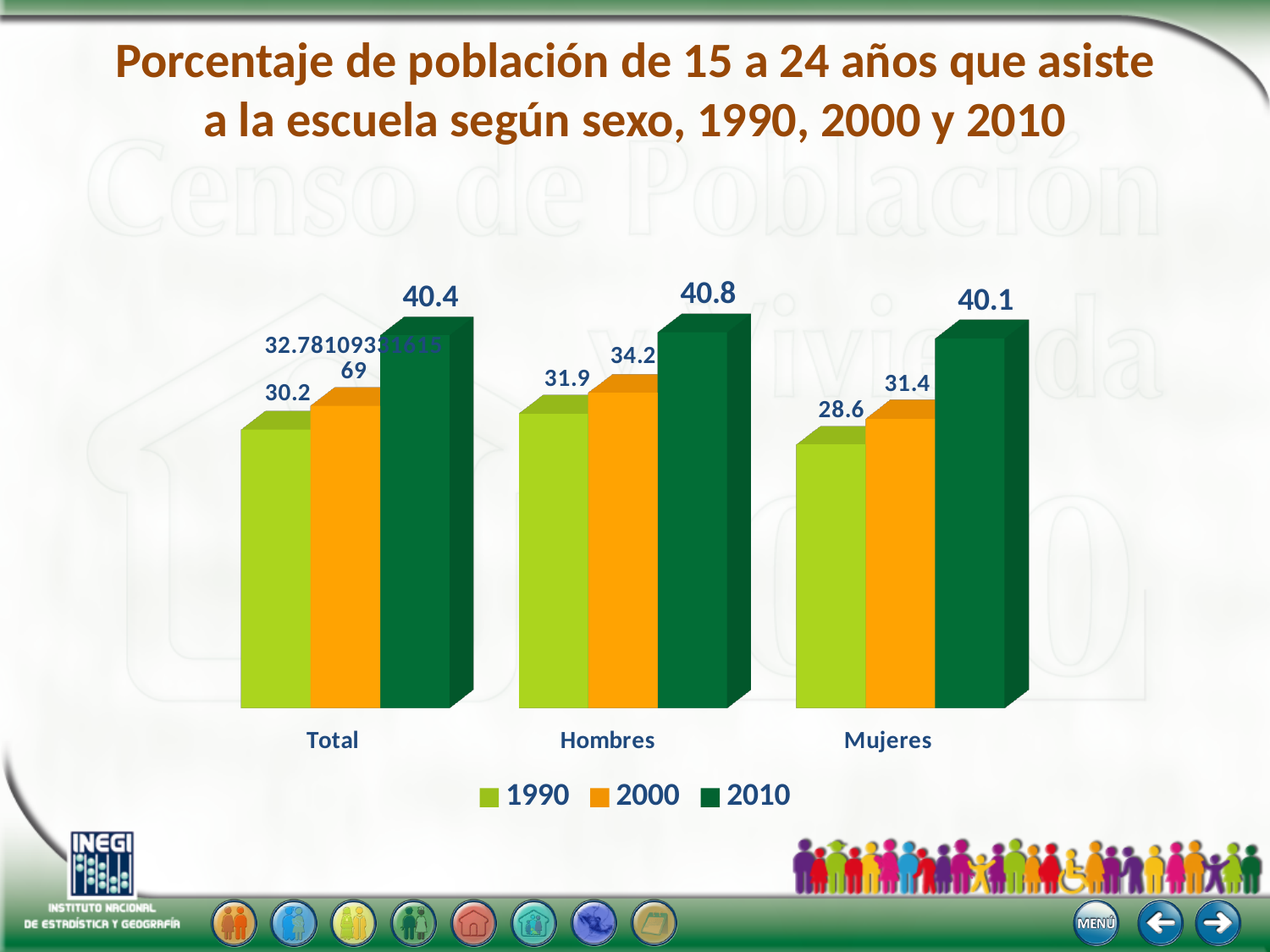
What is the difference between the 2010 and 1990 values for Mujeres? 11.5 Which category has the highest value in 2010? Hombres For Hombres, do the values rise or fall from 1990 to 2010? rise What is the value for Hombres in 2010? 40.8 Which category has the lowest value in 1990? Mujeres Which is larger, the 2000 value for Hombres or the 2000 value for Mujeres? Hombres How many categories are shown on the x axis? 3 How many series does the legend list? 3 What is the value for Total in 2010? 40.4 What is the value for Hombres in 2000? 34.2 What kind of chart is shown on the slide? bar chart What is the value for Mujeres in 1990? 28.6